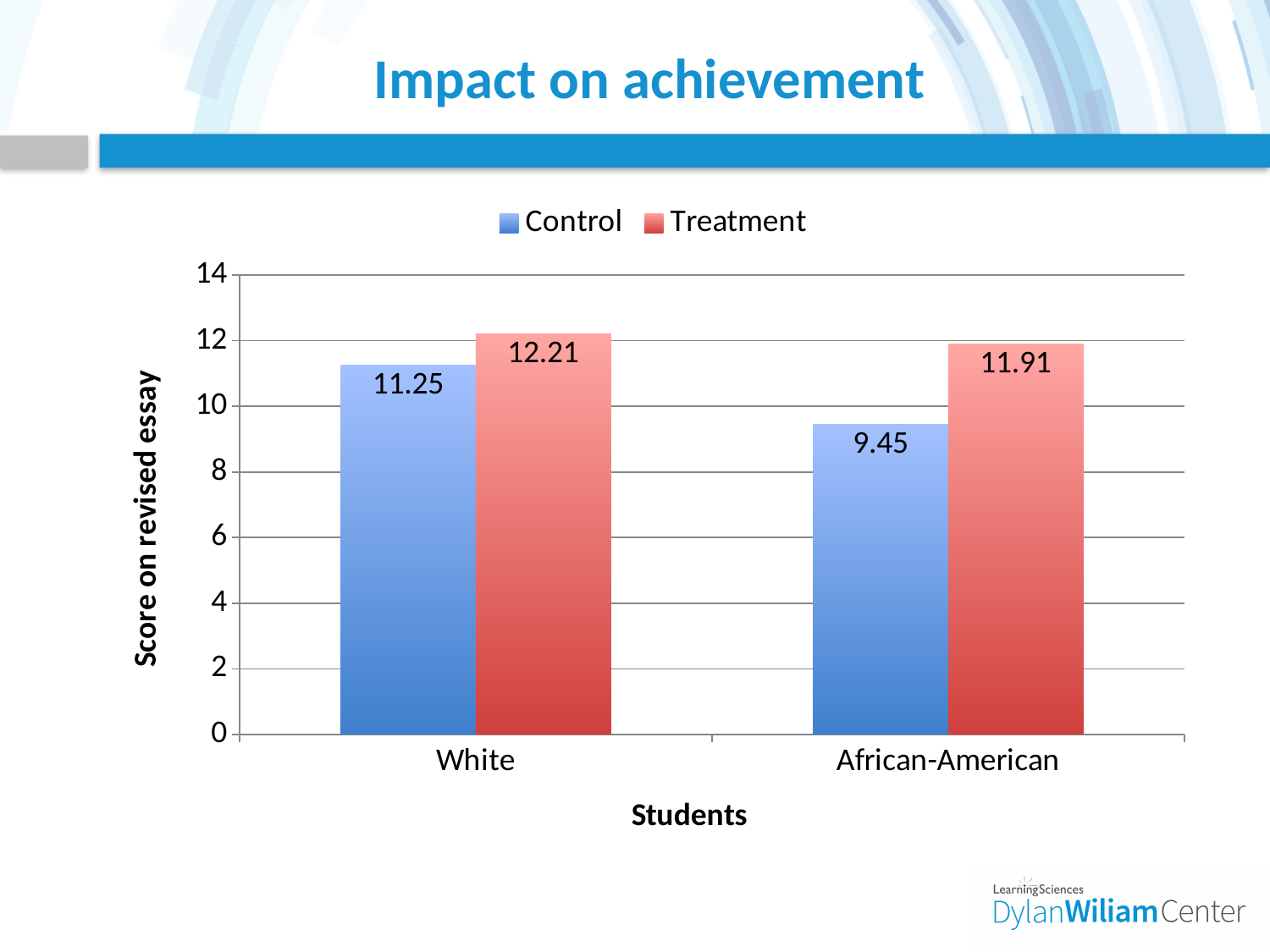
Which bar has the highest value on the chart? Treatment, White What is the Treatment score for White students? 12.21 How many series does the legend list? 2 What is the Treatment score for African-American students? 11.91 Which is larger: the Control score for White students or the Treatment score for African-American students? Treatment score for African-American students What is the difference between the Treatment and Control scores for White students? 0.96 What is the Control score for White students? 11.25 What is the Control score for African-American students? 9.45 Which bar has the lowest value on the chart? Control, African-American How many student categories are shown on the x axis? 2 What kind of chart is shown on the slide? Bar chart What is the difference between the Treatment and Control scores for African-American students? 2.46